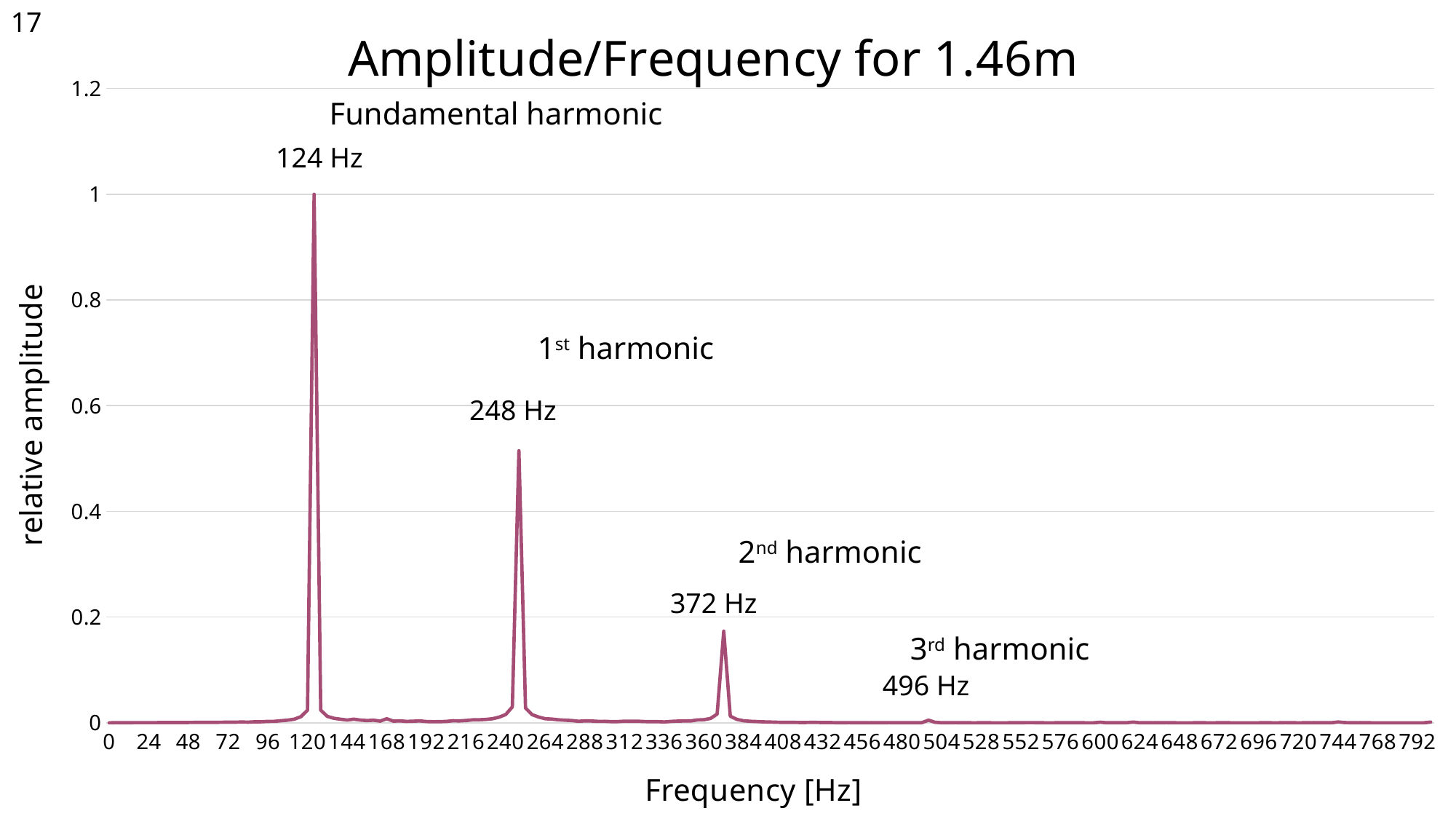
Is the relative amplitude of the peak at 372 Hz greater or less than 0.2? less At what frequency is the fundamental harmonic labelled? 124 Hz What is the label of the x axis? Frequency [Hz] Is the relative amplitude of the peak at 248 Hz greater or less than 0.4? greater How many harmonics are labelled on the chart? 4 What kind of chart is shown on the slide? line chart At what frequency is the 2nd harmonic labelled? 372 Hz Which labelled harmonic has the highest relative amplitude? Fundamental harmonic At what frequency is the 3rd harmonic labelled? 496 Hz Which peak has the larger relative amplitude, the one at 248 Hz or the one at 372 Hz? 248 Hz What is the title of the chart? Amplitude/Frequency for 1.46m At what frequency is the 1st harmonic labelled? 248 Hz